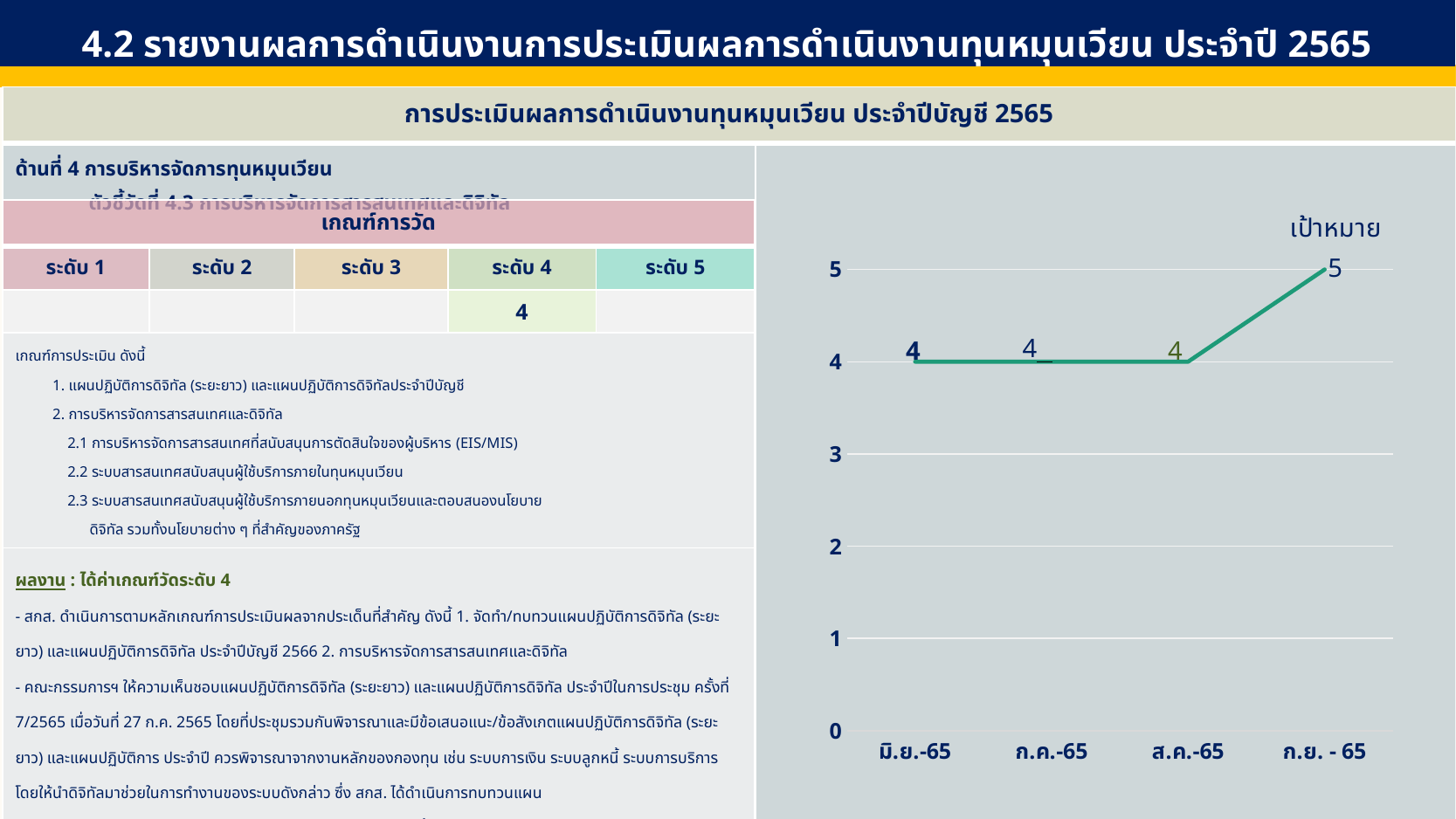
What is the value plotted for ก.ค.-65? 4 Which is larger, the value for ก.ย. - 65 or the value for มิ.ย.-65? ก.ย. - 65 What is the difference between the value for ก.ย. - 65 and the value for ส.ค.-65? 1 What label is written above the last data point on the chart? เป้าหมาย How many months are plotted on the x axis of the chart? 4 Which month has the highest value on the chart? ก.ย. - 65 What is the value plotted for ก.ย. - 65? 5 What is the value plotted for ส.ค.-65? 4 Do the values on the chart rise, fall, or stay flat from มิ.ย.-65 to ส.ค.-65? stay flat What kind of chart is shown on the right side of the slide? line chart What is the value plotted for มิ.ย.-65? 4 Is the value for ก.ค.-65 greater or less than 3? greater